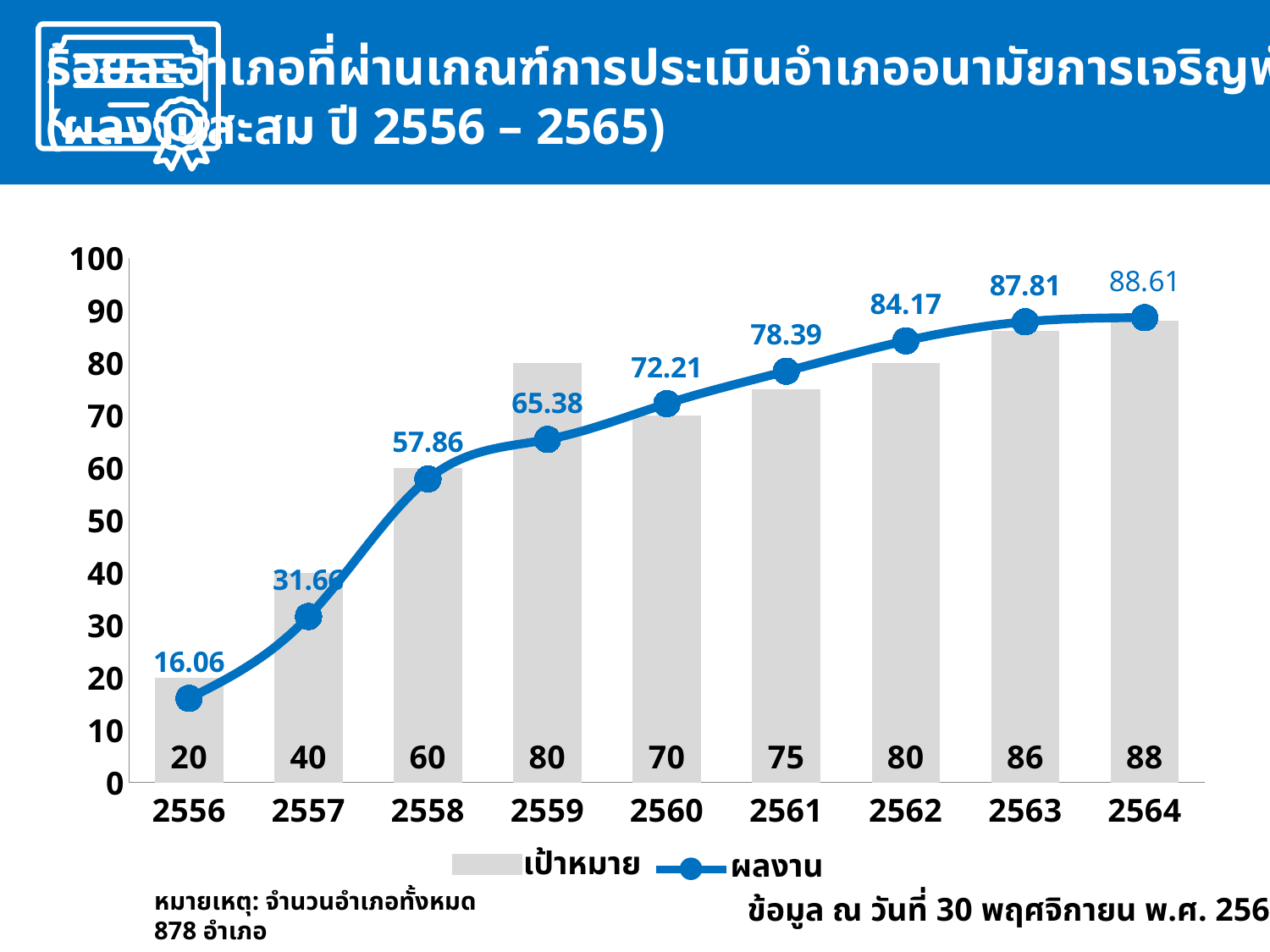
What is the ผลงาน value for 2564? 88.61 What is the ผลงาน value for 2560? 72.21 Does the ผลงาน line rise or fall from 2556 to 2564? rise Which year has the highest ผลงาน value? 2564 Which year has the lowest ผลงาน value? 2556 How many series does the legend list? 2 Which is larger for 2559: the เป้าหมาย value or the ผลงาน value? เป้าหมาย How many years are shown on the x axis? 9 What is the difference between the ผลงาน values for 2562 and 2561? 5.78 Which series is drawn as a line with markers? ผลงาน What is the เป้าหมาย value for 2559? 80 What is the เป้าหมาย value for 2563? 86